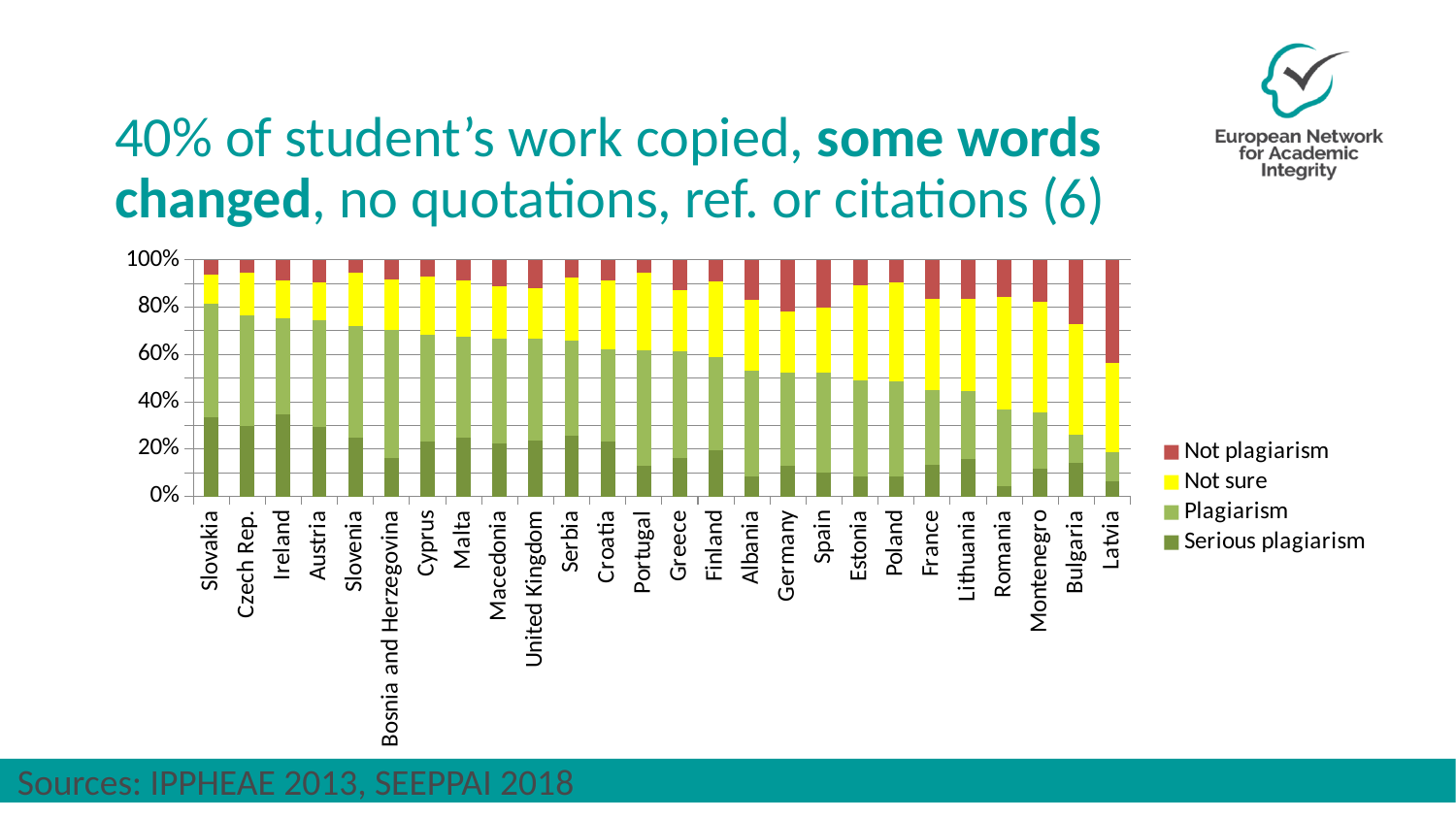
How many countries are shown on the x axis of the chart? 26 How many series does the legend list? 4 Which legend entry is shown in red? Not plagiarism What kind of chart is shown on the slide? Stacked bar chart Is the 'Serious plagiarism' value for Slovakia greater or less than 20%? greater Moving from left to right along the x axis, does the combined 'Plagiarism' plus 'Serious plagiarism' share generally rise or fall? fall Which country has the largest 'Not plagiarism' share? Latvia Is the 'Serious plagiarism' value for Latvia greater or less than 20%? less Is the 'Not plagiarism' value for Bulgaria greater or less than 20%? greater Which has the larger 'Serious plagiarism' share, Slovakia or Latvia? Slovakia Which has the larger 'Not plagiarism' share, Czech Rep. or Montenegro? Montenegro